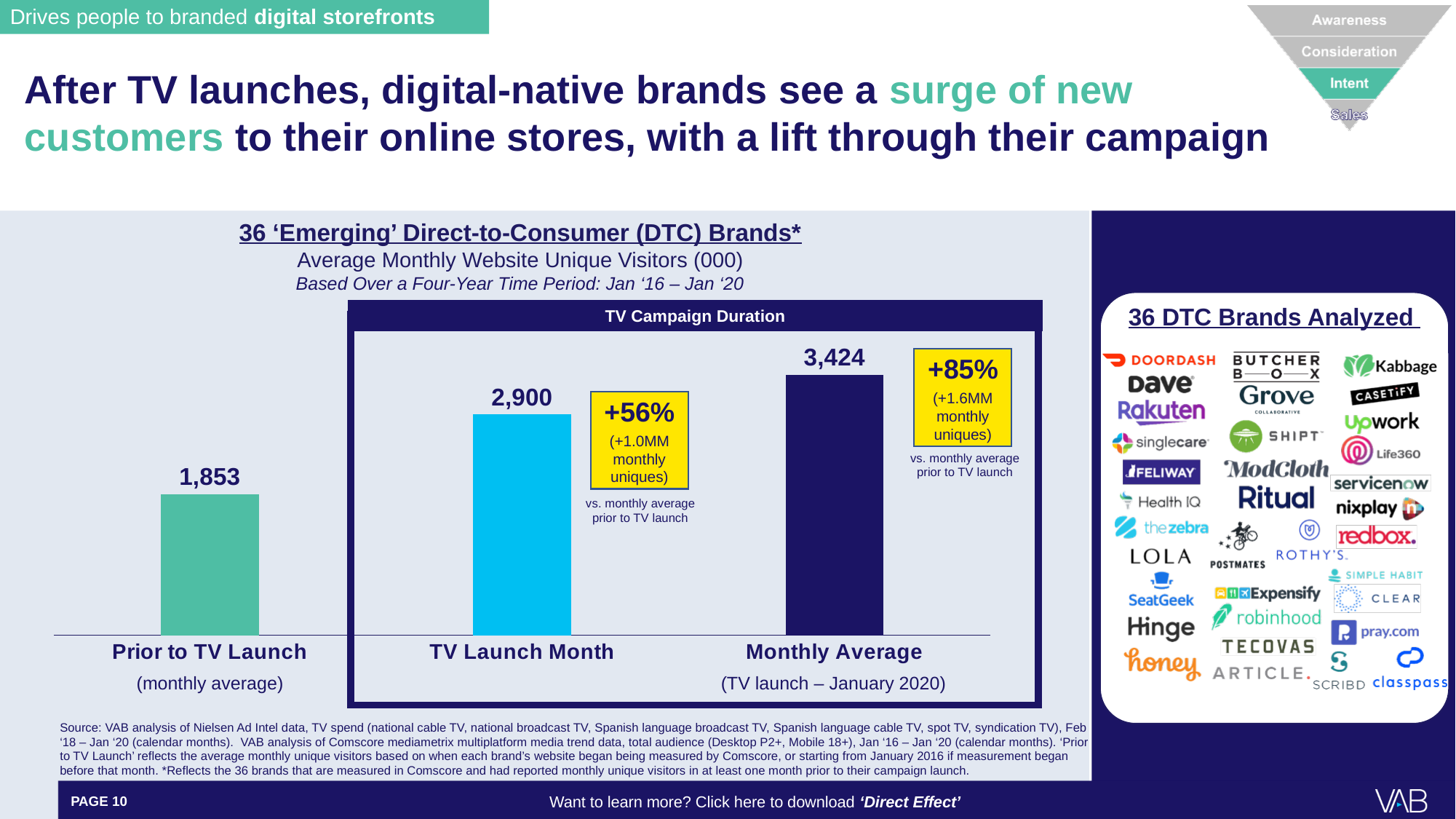
What is the difference between the TV Launch Month value and the Prior to TV Launch value? 1,047 What is the average monthly website unique visitors (000) for Prior to TV Launch? 1,853 Which is larger, the value for TV Launch Month or the value for Monthly Average? Monthly Average Which category has the lowest value in the chart? Prior to TV Launch What percentage lift does the callout show for TV Launch Month vs. the monthly average prior to TV launch? +56% How many bars are plotted in the chart? 3 Do the values rise or fall from left to right across the chart? Rise What kind of chart is shown on the slide? Bar chart What is the value shown for Monthly Average (TV launch – January 2020)? 3,424 What is the difference between the Monthly Average value and the Prior to TV Launch value? 1,571 Which category has the highest value in the chart? Monthly Average What is the value shown for TV Launch Month? 2,900